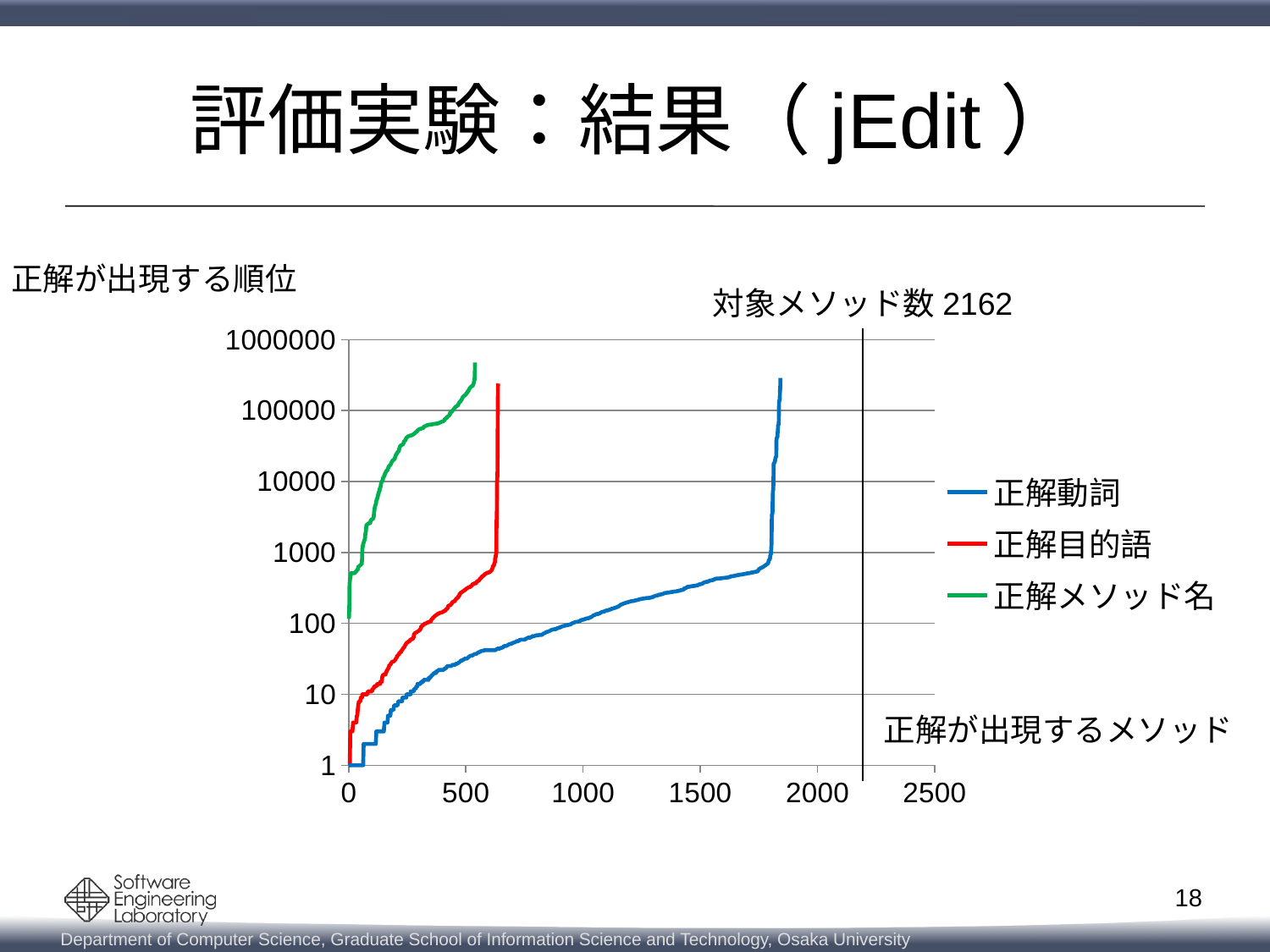
Is the x value at which the 正解メソッド名 line ends greater or less than 1000? less Which series is drawn in green according to the legend? 正解メソッド名 Do the values of the 正解動詞 series rise or fall as x increases? rise What number of target methods (対象メソッド数) is annotated on the chart? 2162 Which series extends furthest to the right along the x axis? 正解動詞 Which series reaches the smallest x value before rising steeply? 正解メソッド名 Is the x value at which the 正解目的語 line ends greater or less than 1000? less How many series does the legend list? 3 What kind of chart is shown on the slide? line chart What is the highest tick value shown on the y axis? 1000000 Is the x value at which the 正解動詞 line ends greater or less than 1500? greater Which series is drawn in blue according to the legend? 正解動詞